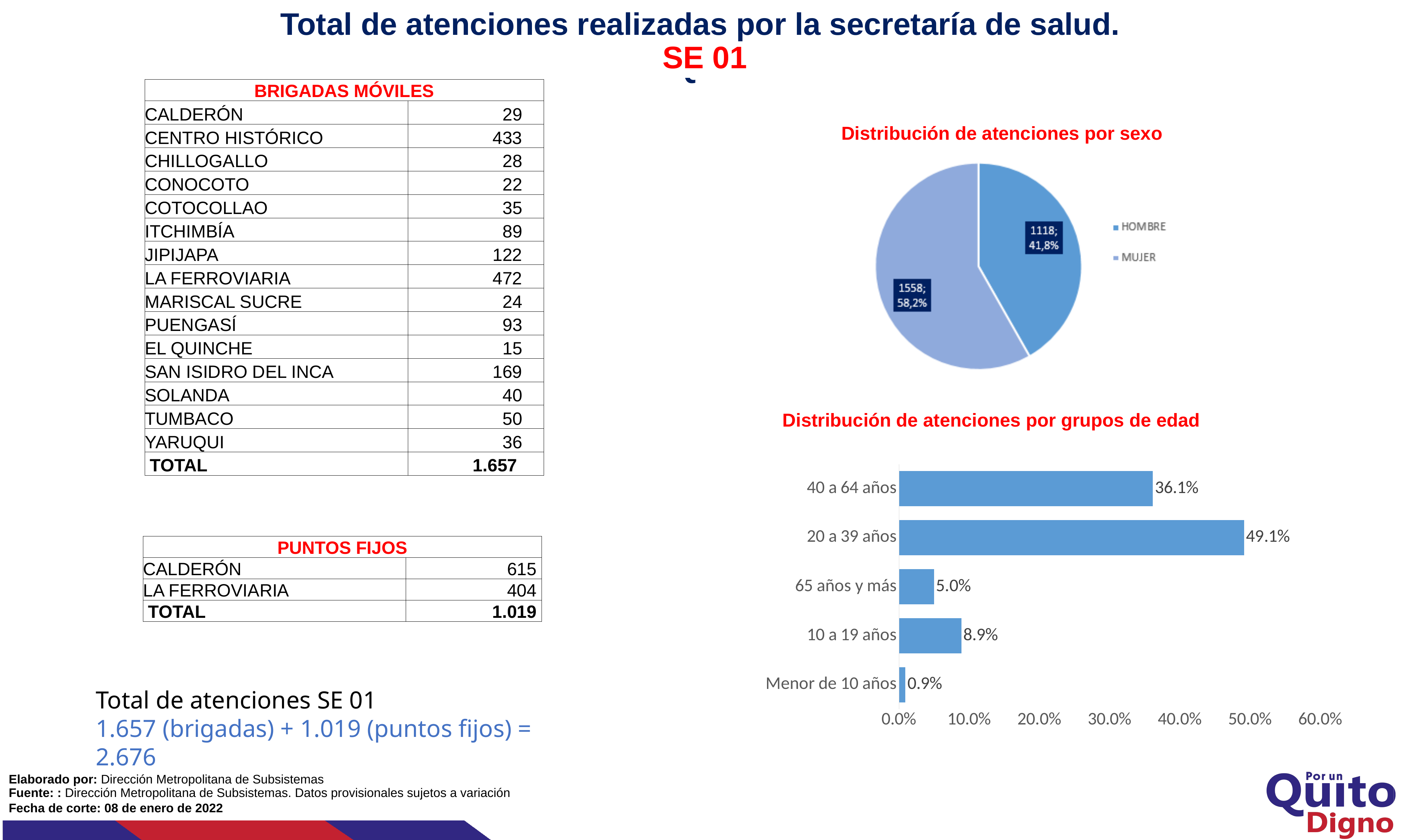
In the 'Distribución de atenciones por sexo' chart, what kind of chart is shown? pie chart In the 'Distribución de atenciones por grupos de edad' chart, how many age groups are shown? 5 In the 'Distribución de atenciones por grupos de edad' chart, what is the value for '20 a 39 años'? 49.1% In the 'Distribución de atenciones por grupos de edad' chart, what kind of chart is shown? bar chart In the 'Distribución de atenciones por grupos de edad' chart, which age group has the lowest value? Menor de 10 años In the 'Distribución de atenciones por grupos de edad' chart, what is the value for '65 años y más'? 5.0% In the 'Distribución de atenciones por grupos de edad' chart, which age group has the highest value? 20 a 39 años In the 'Distribución de atenciones por sexo' chart, which category has the larger slice, HOMBRE or MUJER? MUJER In the 'Distribución de atenciones por sexo' chart, what share of attentions corresponds to MUJER? 58,2% In the 'Distribución de atenciones por grupos de edad' chart, what is the difference between the values for '20 a 39 años' and '40 a 64 años'? 13.0% In the 'Distribución de atenciones por sexo' chart, what is the number of attentions for HOMBRE? 1118 In the 'Distribución de atenciones por sexo' chart, how many entries does the legend list? 2